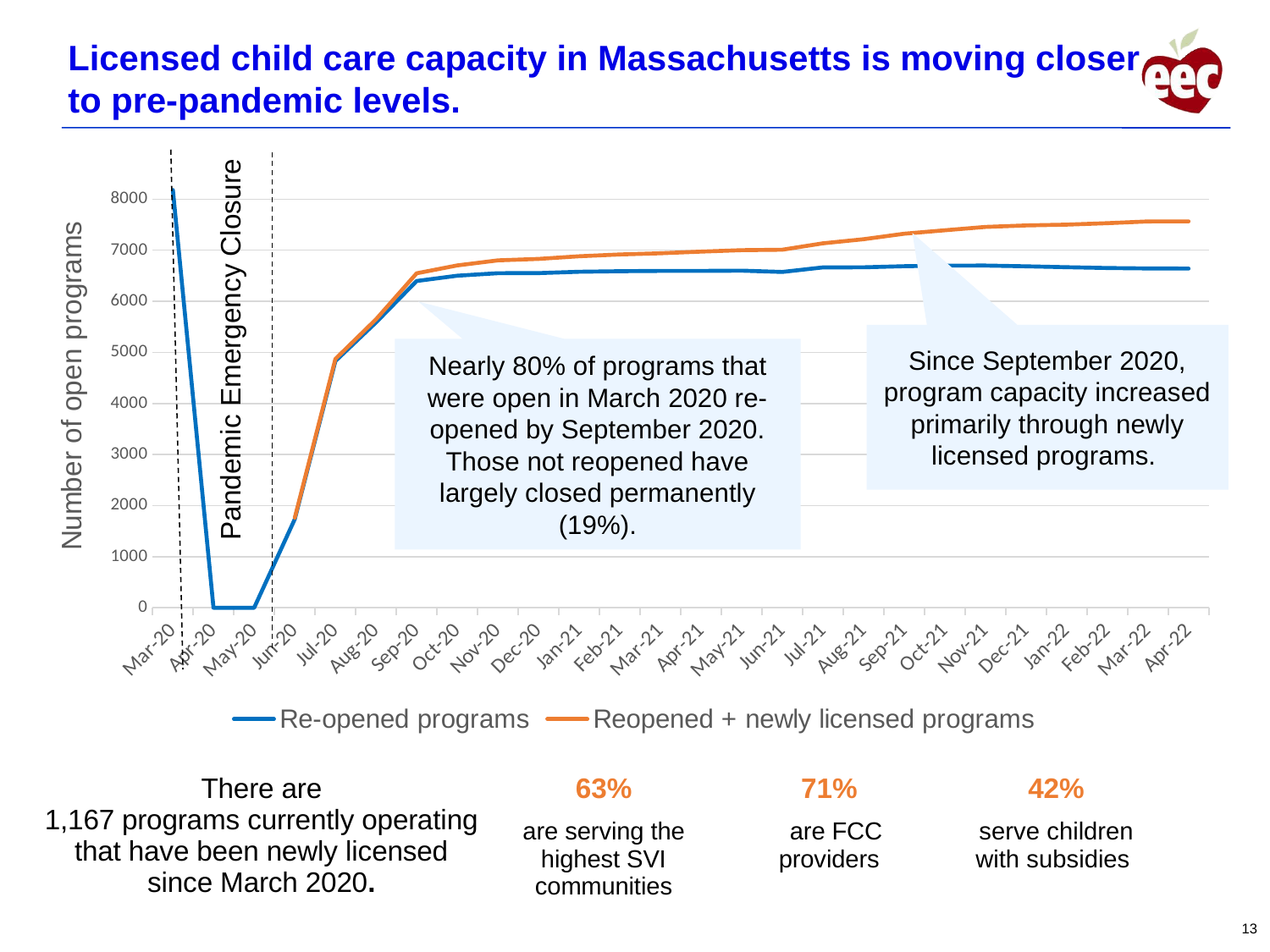
Which month has the highest value for Re-opened programs? Mar-20 From Sep-20 to Apr-22, does the Reopened + newly licensed programs line rise or fall? rise Is the value for Re-opened programs in Apr-22 greater or less than 7000? less Is the value for Reopened + newly licensed programs in Apr-22 greater or less than 7000? greater How many months are shown along the x axis of the chart? 26 What period is marked by the dashed vertical lines on the chart? Pandemic Emergency Closure Is the value for Re-opened programs in Jul-20 greater or less than 5000? less How many series does the chart legend list? 2 What is the label on the y axis of the chart? Number of open programs In Apr-22, which series has the larger value: Re-opened programs or Reopened + newly licensed programs? Reopened + newly licensed programs What kind of chart is shown on the slide? line chart